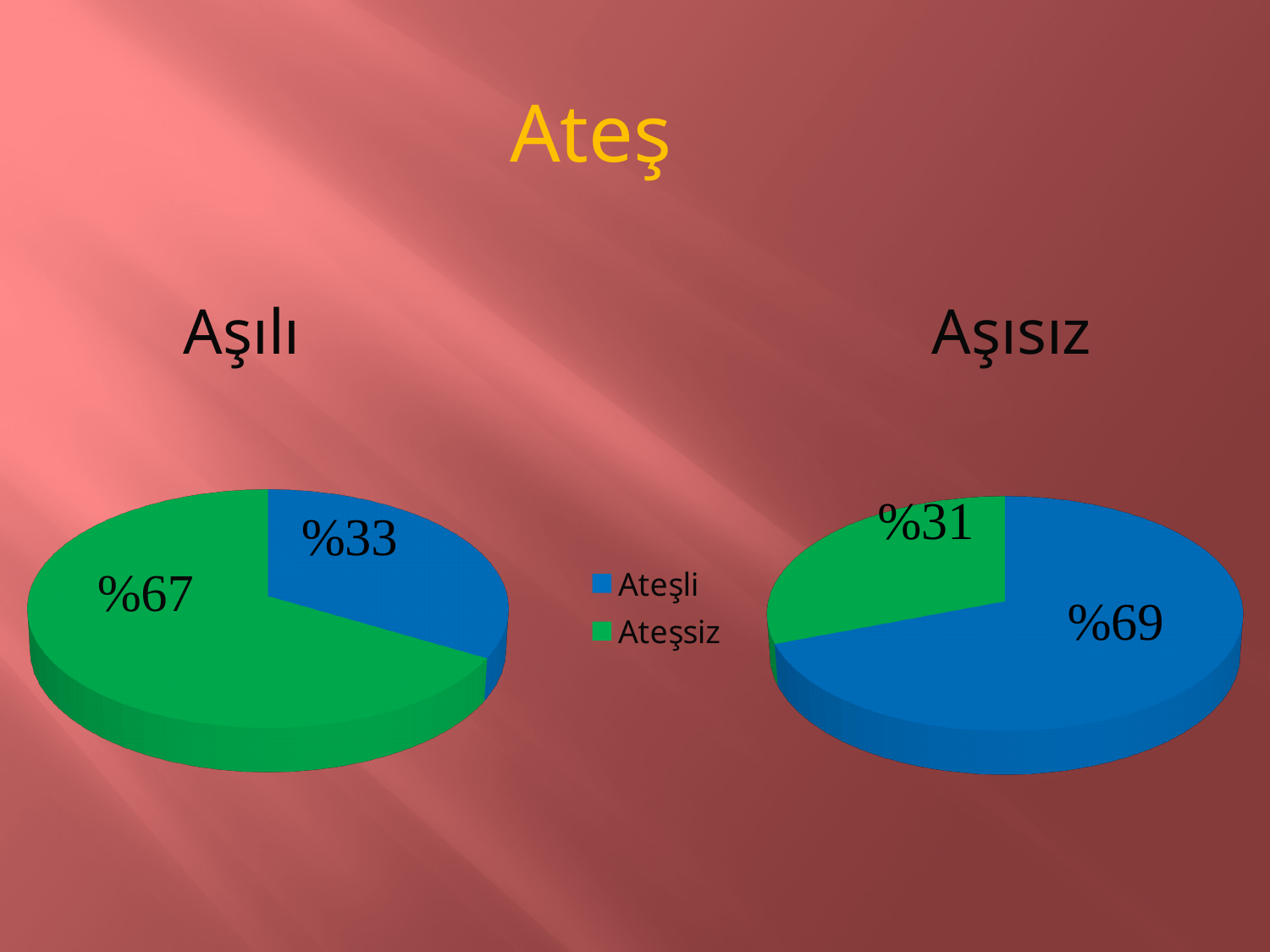
In the Aşısız pie chart, what is the value for Ateşli? %69 In the Aşılı pie chart, what is the value for Ateşsiz? %67 What type of chart is used on this slide? Pie chart In the Aşılı pie chart, what is the difference between the Ateşsiz and Ateşli values? %34 In the Aşısız pie chart, which category has the smallest slice? Ateşsiz In the Aşısız pie chart, what is the difference between the Ateşli and Ateşsiz values? %38 Which colour represents Ateşli in the legend? Blue How many slices does the Aşılı pie chart have? 2 In the Aşılı pie chart, what is the value for Ateşli? %33 In the Aşılı pie chart, which category has the largest slice? Ateşsiz Is the Ateşli value larger in the Aşılı chart or the Aşısız chart? Aşısız In the Aşısız pie chart, what is the value for Ateşsiz? %31